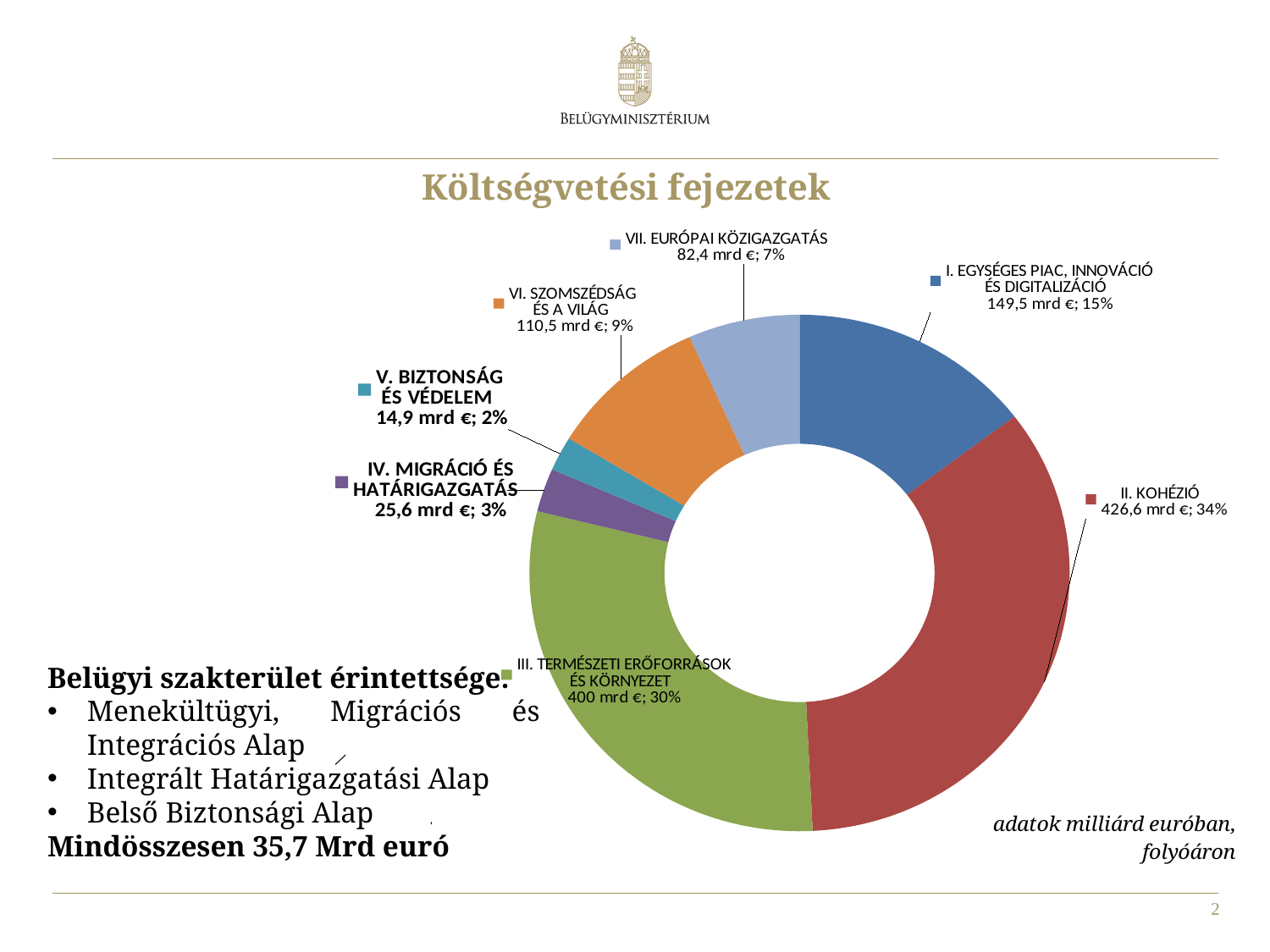
Which category has the largest slice? II. KOHÉZIÓ What share of the total does III. TERMÉSZETI ERŐFORRÁSOK ÉS KÖRNYEZET represent? 30% Which is larger, VI. SZOMSZÉDSÁG ÉS A VILÁG or VII. EURÓPAI KÖZIGAZGATÁS? VI. SZOMSZÉDSÁG ÉS A VILÁG What percentage is shown for VII. EURÓPAI KÖZIGAZGATÁS? 7% What is the value shown for V. BIZTONSÁG ÉS VÉDELEM? 14,9 mrd € What is the value shown for II. KOHÉZIÓ? 426,6 mrd € Which category has the smallest slice? V. BIZTONSÁG ÉS VÉDELEM How many categories (slices) does the chart show? 7 What is the value shown for IV. MIGRÁCIÓ ÉS HATÁRIGAZGATÁS? 25,6 mrd € What is the difference in value between II. KOHÉZIÓ and III. TERMÉSZETI ERŐFORRÁSOK ÉS KÖRNYEZET? 26,6 mrd € What is the title of the chart? Költségvetési fejezetek What kind of chart is shown on the slide? Doughnut (pie) chart